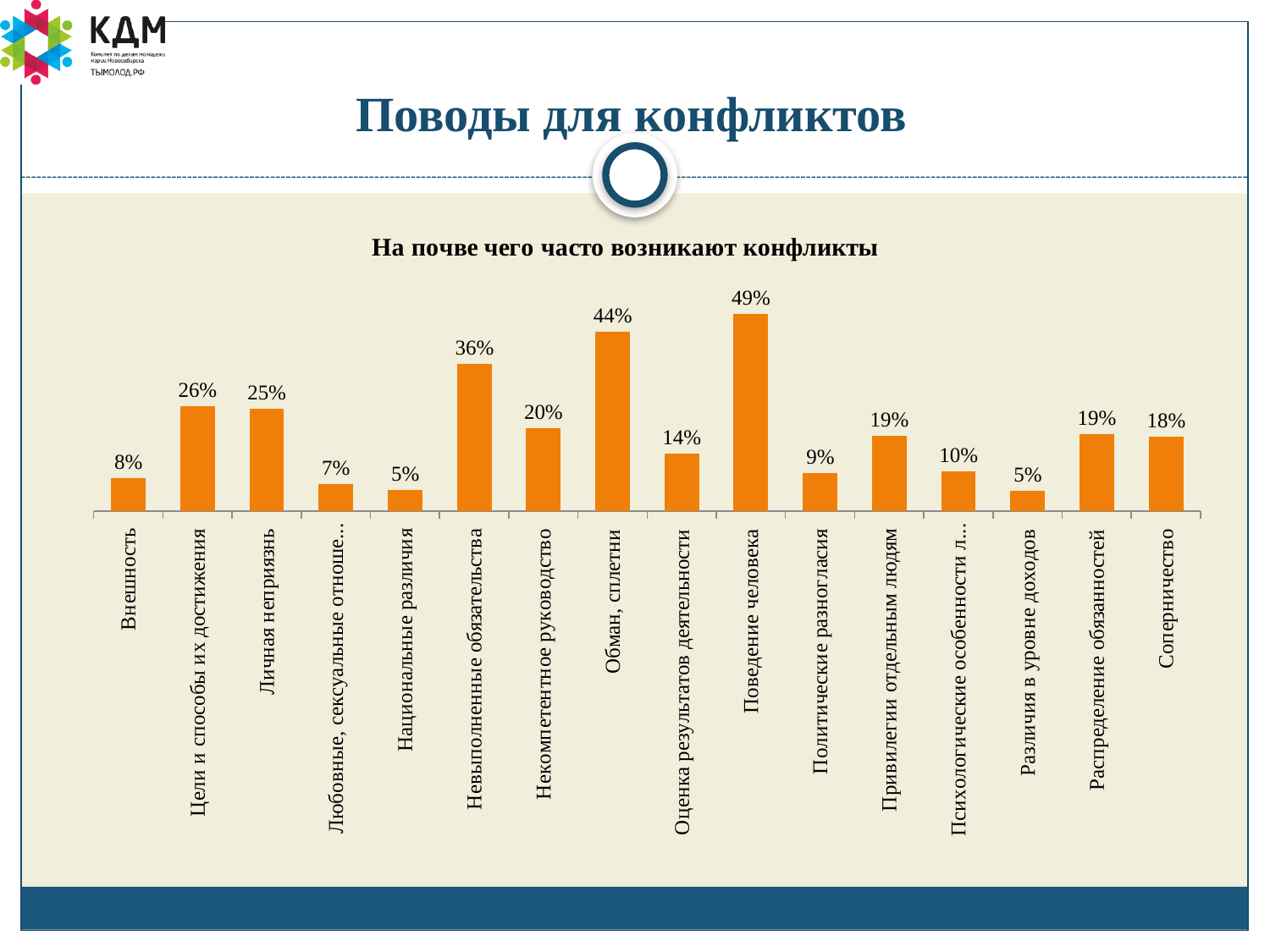
What value is shown for «Невыполненные обязательства»? 36% What is the difference between the values for «Обман, сплетни» and «Некомпетентное руководство»? 24% What kind of chart is shown on the slide? Bar chart What value is shown for «Внешность»? 8% What is the title of the chart? На почве чего часто возникают конфликты What value is shown for «Соперничество»? 18% What is the difference between the values for «Цели и способы их достижения» and «Личная неприязнь»? 1% How many categories are shown on the x axis? 16 Which is larger, the value for «Оценка результатов деятельности» or the value for «Политические разногласия»? Оценка результатов деятельности What value is shown for «Поведение человека»? 49% Which category has the highest value? Поведение человека Which is larger, the value for «Привилегии отдельным людям» or the value for «Психологические особенности л...»? Привилегии отдельным людям